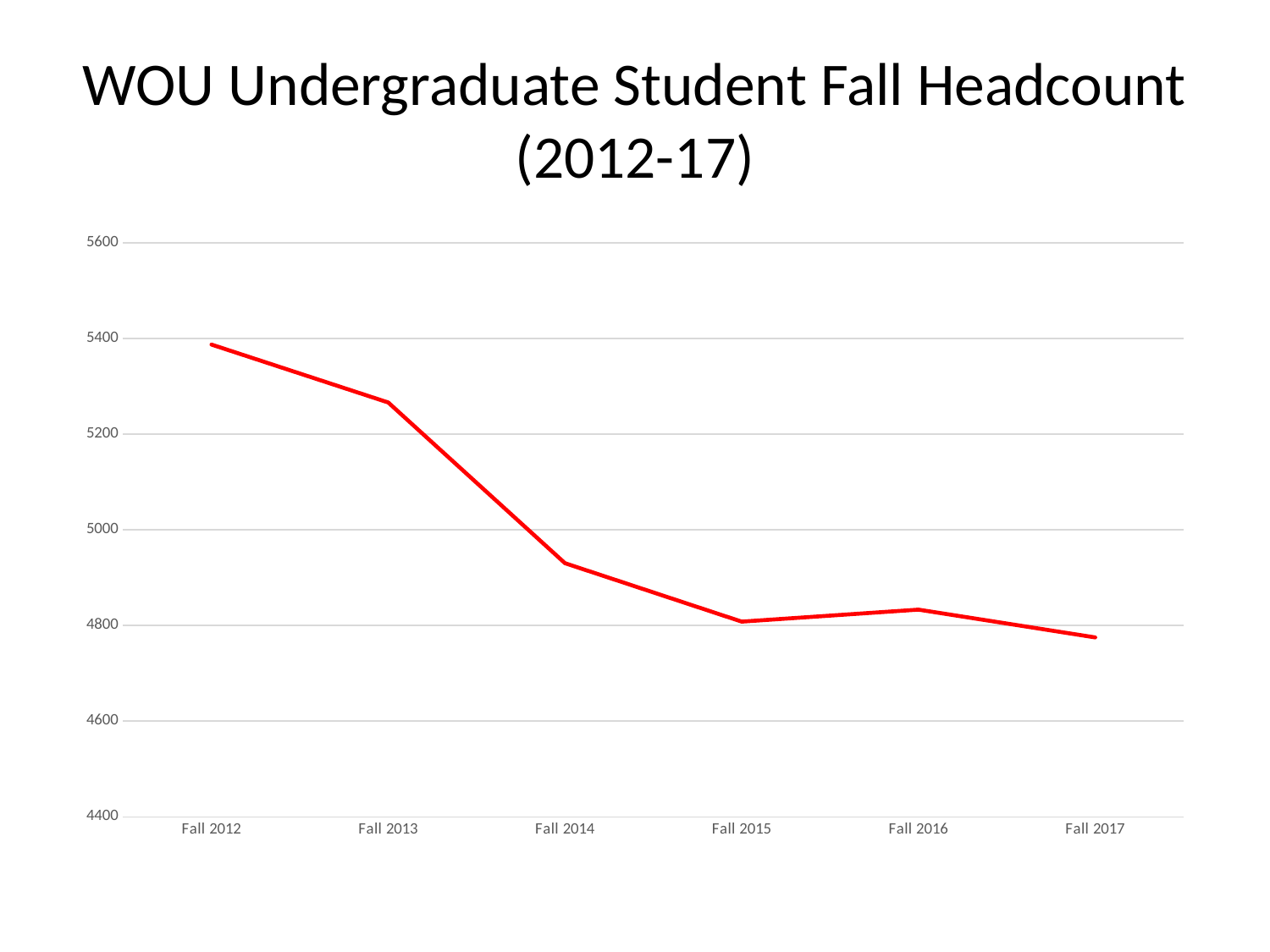
Is the headcount for Fall 2017 greater or less than 5000? less Is the headcount for Fall 2014 greater or less than 5000? less How many data points are plotted on the chart? 6 What is the title of the chart? WOU Undergraduate Student Fall Headcount (2012-17) What colour is the line on the chart? red Overall, do the headcount values rise or fall from Fall 2012 to Fall 2017? fall Which is larger, the headcount for Fall 2013 or for Fall 2014? Fall 2013 Is the headcount for Fall 2015 greater or less than 5000? less Which fall term has the highest undergraduate headcount? Fall 2012 What kind of chart is shown on the slide? line chart